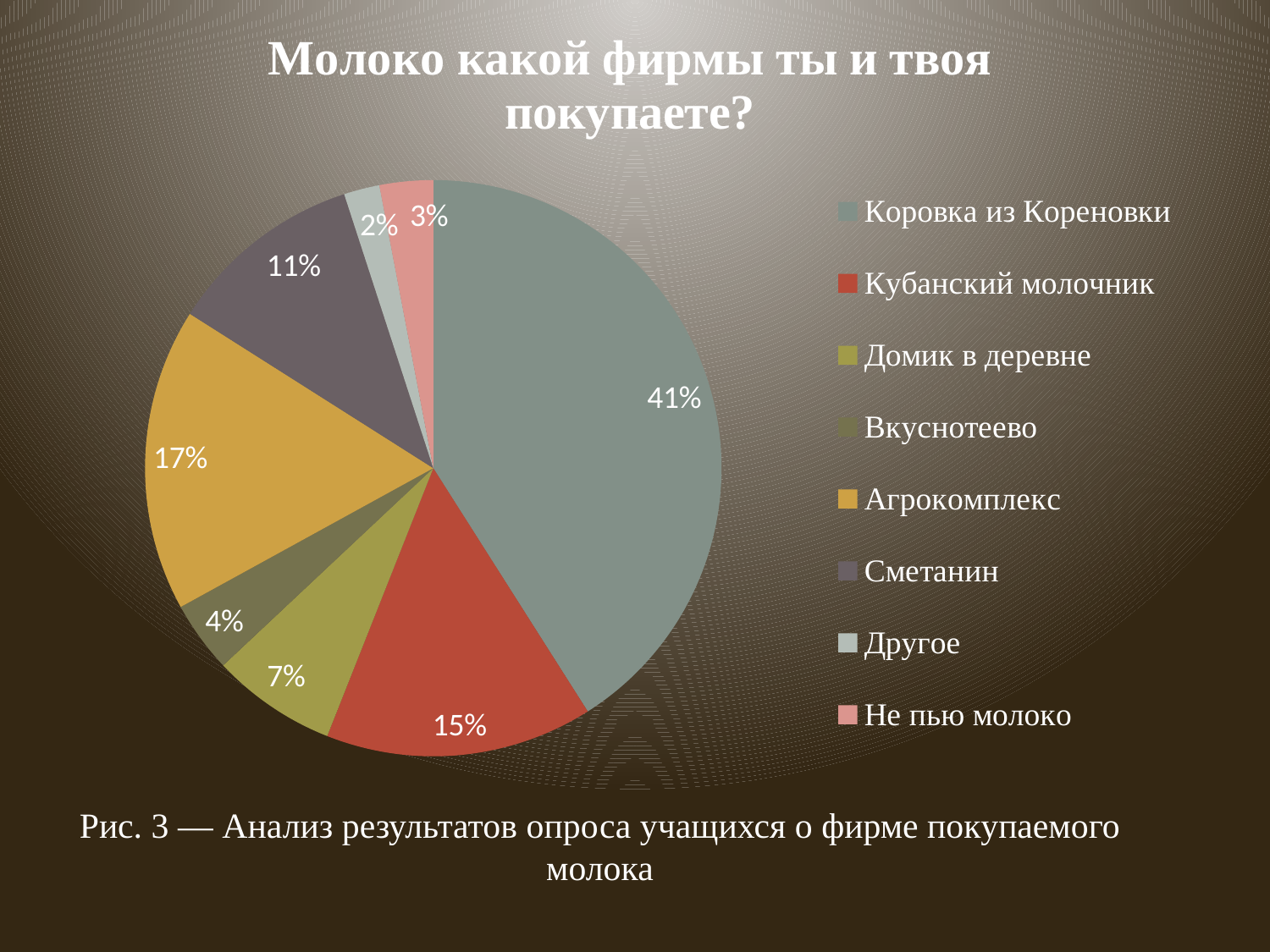
What is the value for Агрокомплекс? 17% What is the value for Сметанин? 11% How many categories does the legend list? 8 Which is larger, Домик в деревне or Вкуснотеево? Домик в деревне What is the value for Кубанский молочник? 15% What is the title of the chart? Молоко какой фирмы ты и твоя покупаете? Which category has the smallest slice? Другое Which category has the largest slice? Коровка из Кореновки What share of the pie does Коровка из Кореновки have? 41% What type of chart is shown on the slide? pie chart What is the difference between the values for Агрокомплекс and Кубанский молочник? 2% What is the value for Не пью молоко? 3%